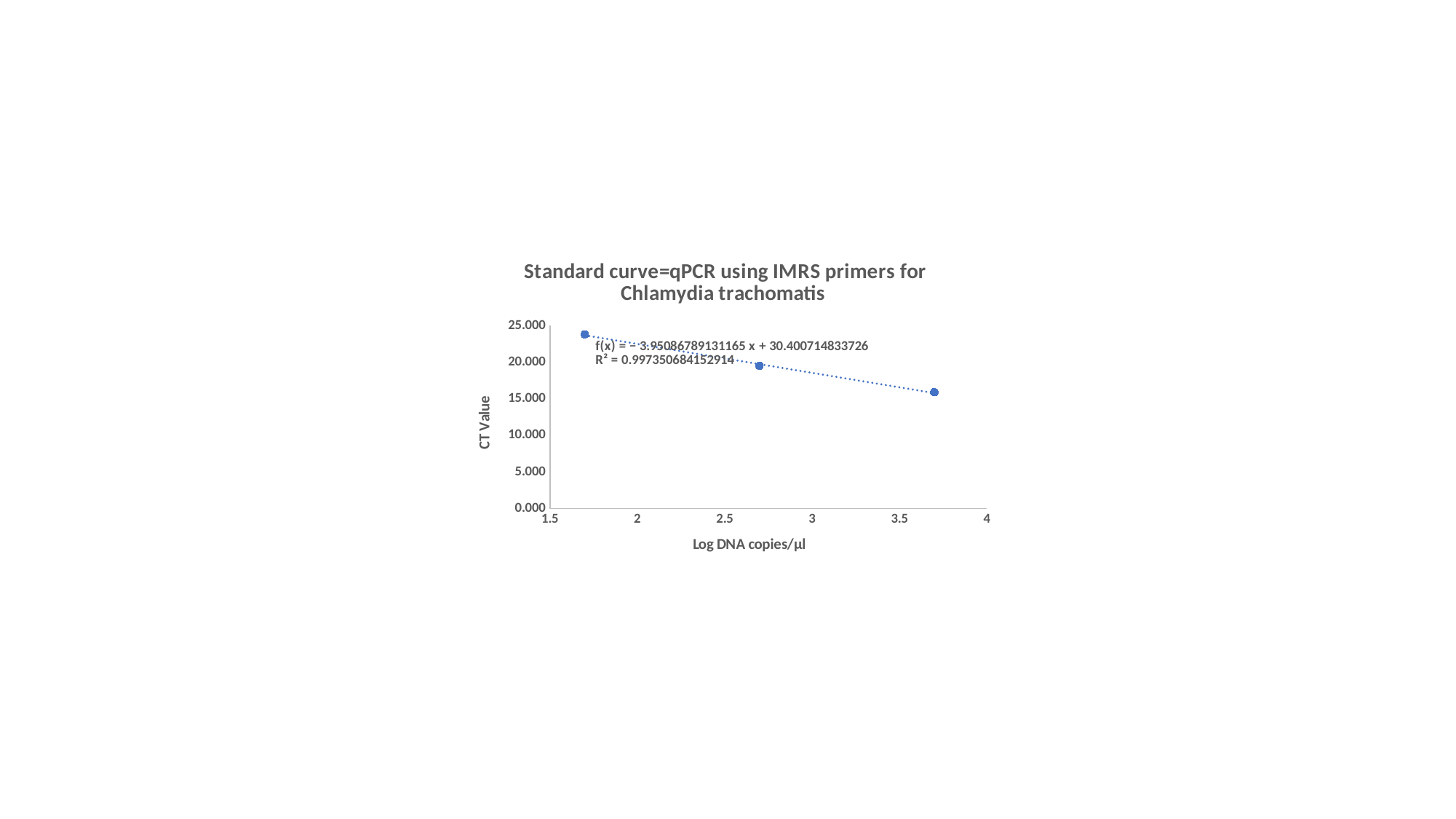
Is the CT value of the rightmost data point greater or less than 20.000? less What is the label of the x axis? Log DNA copies/µl What is the trendline equation printed on the chart? f(x) = -3.95086789131165 x + 30.400714833726 Which data point has the lowest CT value: the leftmost, middle, or rightmost? Rightmost What is the R² value printed on the chart? 0.997350684152914 What kind of chart is shown on the slide? Scatter chart Which data point has the highest CT value: the leftmost, middle, or rightmost? Leftmost Is the CT value of the leftmost data point greater or less than 20.000? greater How many data points are plotted on the chart? 3 Do the CT values rise or fall as Log DNA copies/µl increases along the x axis? Fall Which has a larger CT value, the leftmost data point or the rightmost data point? Leftmost Is the CT value of the leftmost data point greater or less than 25.000? less